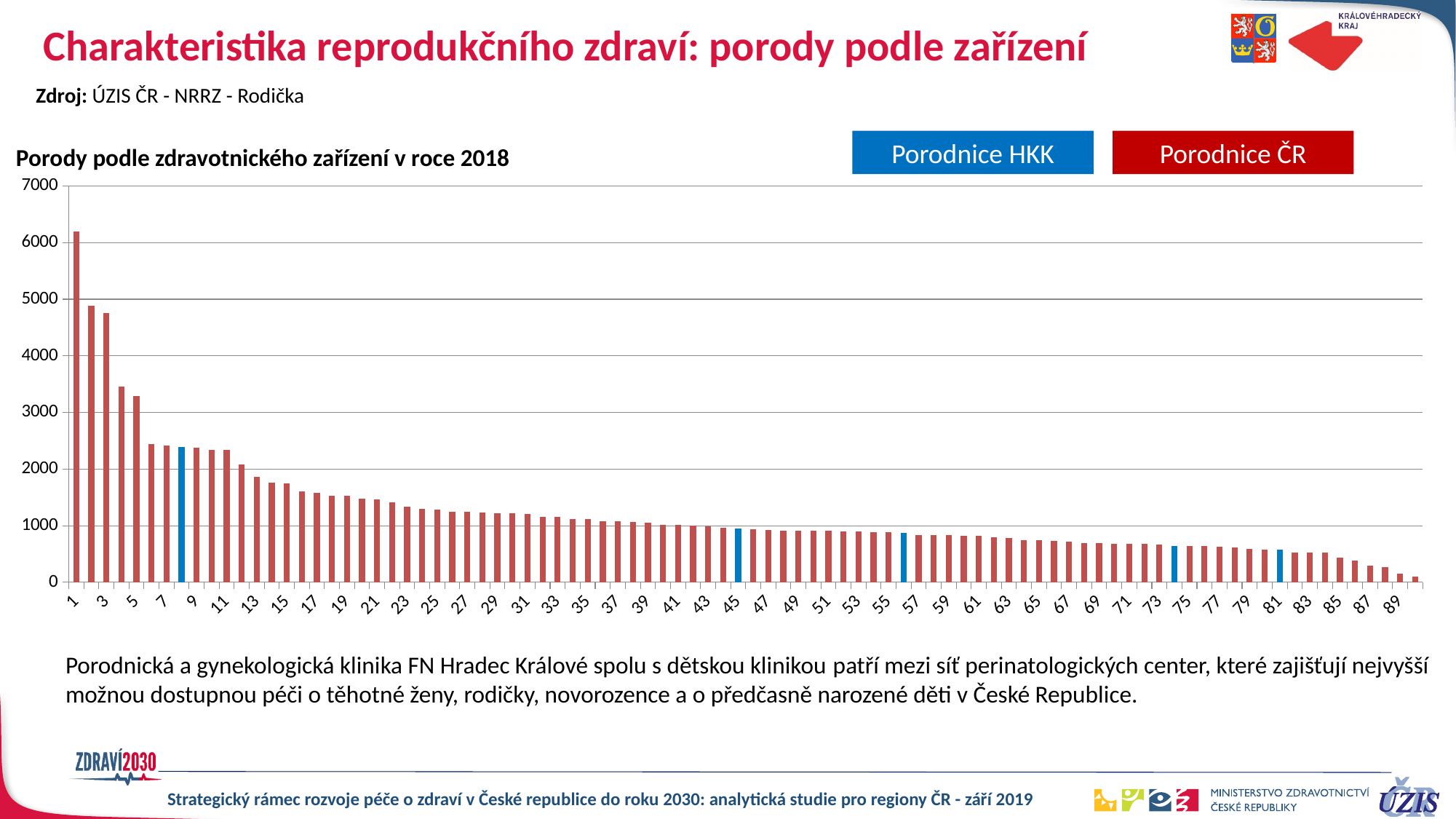
Which category has the highest bar? 1 Which is larger, the value for category 13 or the value for category 21? category 13 Is the value for category 3 greater or less than 5000? less Is the value for category 89 greater or less than 500? less Which colour represents Porodnice HKK in the legend? blue Do the bar values rise or fall from left to right along the x axis? fall What is the title of the chart? Porody podle zdravotnického zařízení v roce 2018 How many series does the legend list? 2 Is the value for category 5 greater or less than 3000? greater What kind of chart is shown on the slide? bar chart